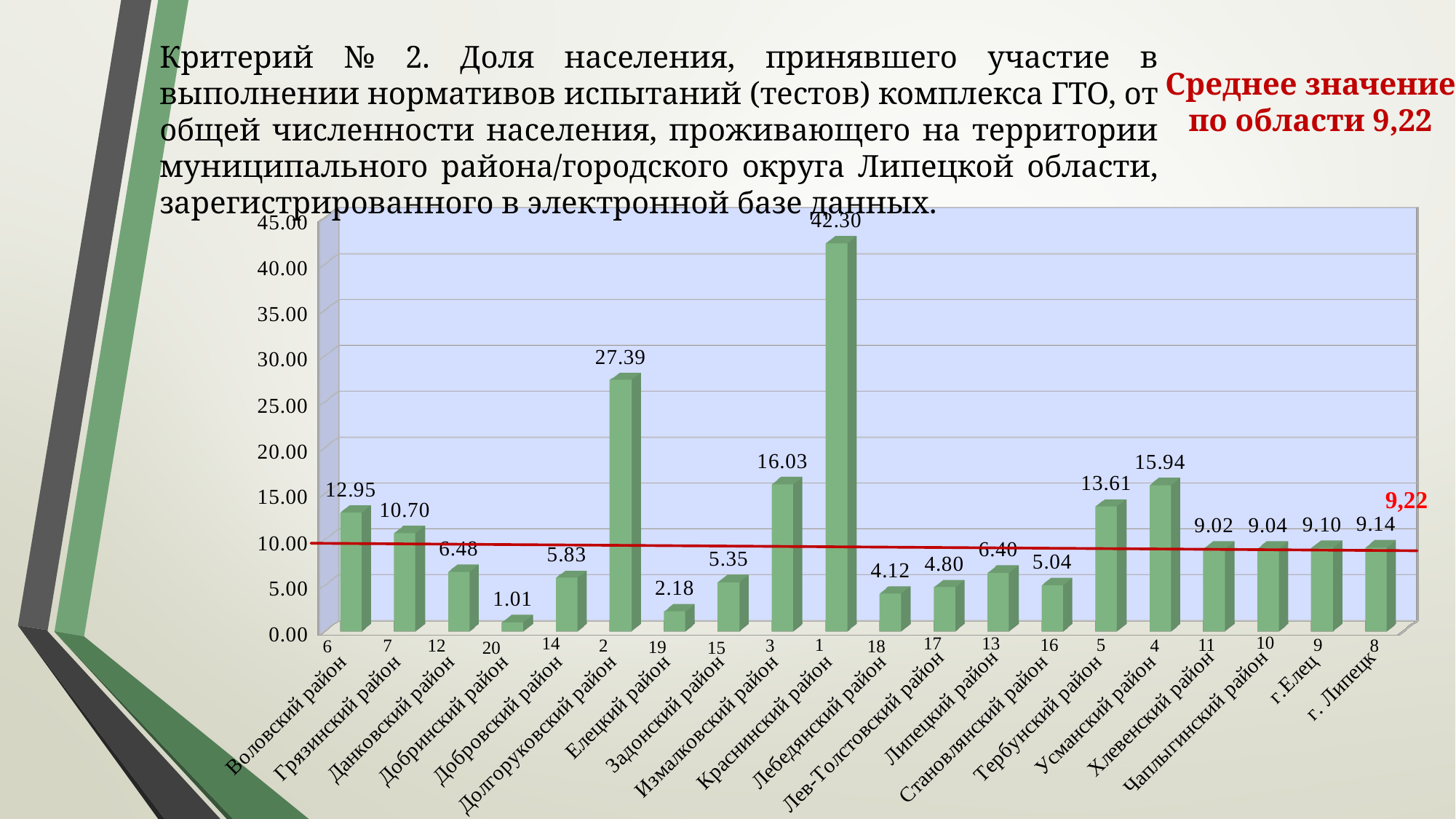
How many districts/cities are shown on the chart? 20 Which district has the lowest value on the chart? Добринский район What kind of chart is shown on the slide? Bar chart What is the regional average value marked by the red line on the chart? 9,22 Which is larger, the value for Воловский район or the value for Тербунский район? Тербунский район What is the difference between the values for Измалковский район and Грязинский район? 5.33 Which district has the highest value on the chart? Краснинский район What value is shown for Добринский район? 1.01 What value is shown for Краснинский район? 42.30 What is the difference between the values for Краснинский район and Долгоруковский район? 14.91 What value is shown for Долгоруковский район? 27.39 What value is shown for Усманский район? 15.94